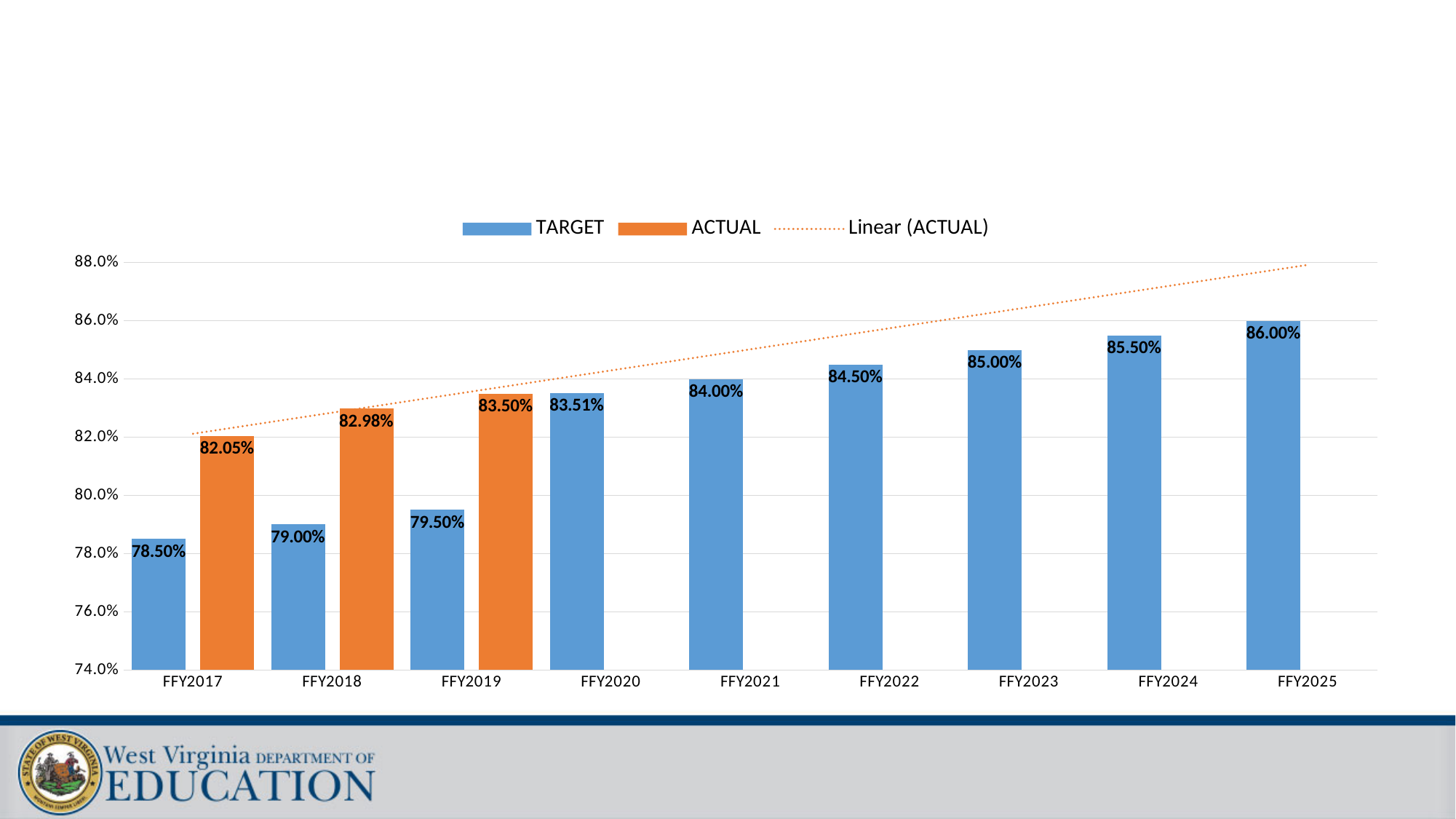
What kind of chart is shown on the slide? Bar chart What is the ACTUAL value for FFY2018? 82.98% How many entries does the legend list? 3 Do the TARGET values rise or fall from FFY2017 to FFY2025? Rise What is the difference between the ACTUAL and TARGET values for FFY2017? 3.55% What is the TARGET value for FFY2020? 83.51% Is the TARGET value for FFY2021 greater or less than 82.0%? greater Which year has the highest ACTUAL value? FFY2019 What is the TARGET value for FFY2025? 86.00% How many years are shown on the x axis? 9 Which year has the lowest TARGET value? FFY2017 Which is larger for FFY2019, the TARGET or the ACTUAL value? ACTUAL